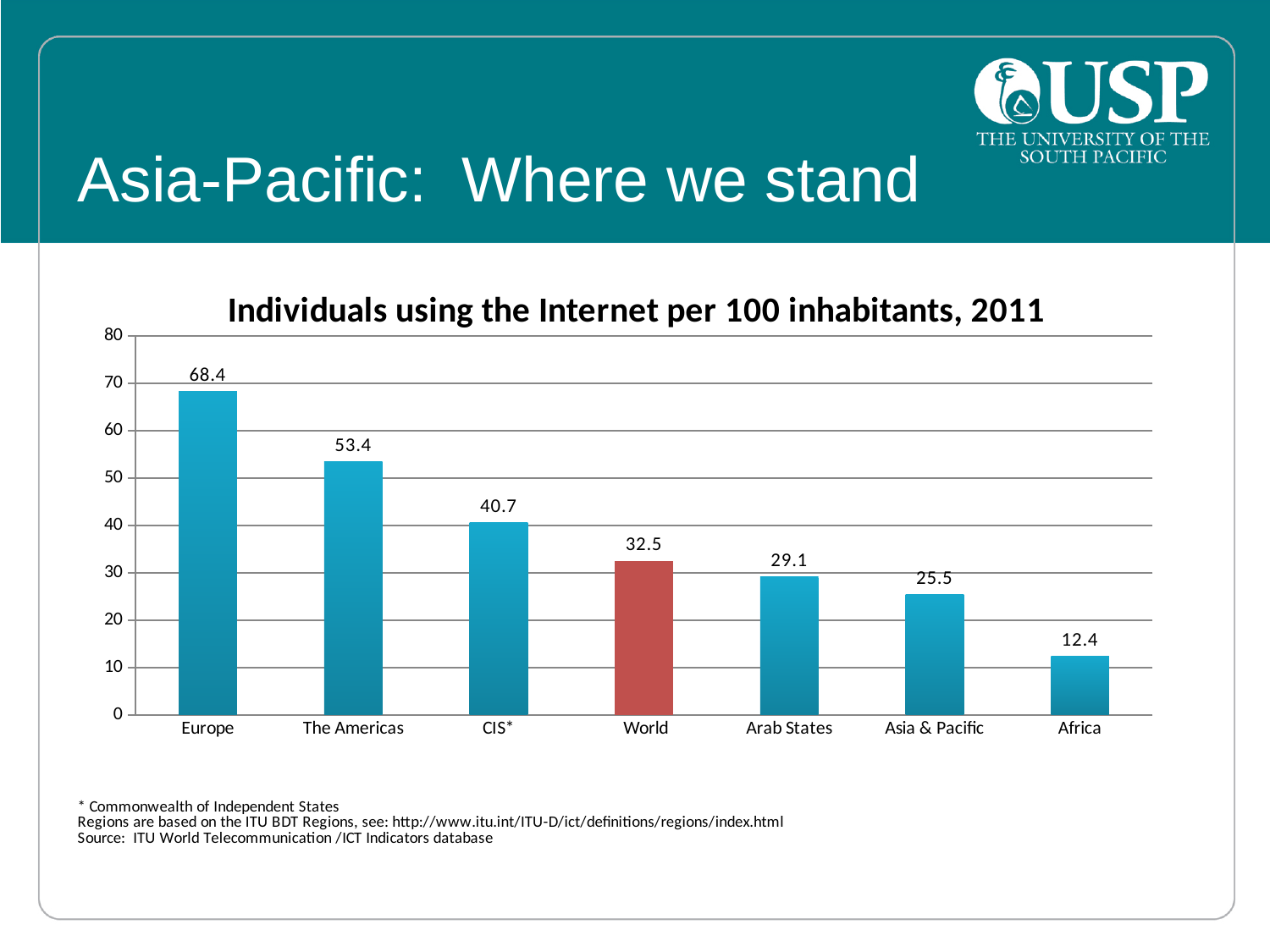
Which region has the highest number of individuals using the Internet per 100 inhabitants? Europe How many regions are shown in the chart? 7 What is the value for Europe in the chart? 68.4 Which is larger, the value for CIS* or the value for Arab States? CIS* What kind of chart is shown on the slide? Bar chart What is the difference between the World value and the Asia & Pacific value? 7 What is the value for Asia & Pacific? 25.5 What is the difference between the values for Europe and Africa? 56 Which bar is shown in a different colour (red) from the others? World Which region has the lowest value in the chart? Africa Is the value for The Americas greater or less than 50? greater What is the value for World? 32.5